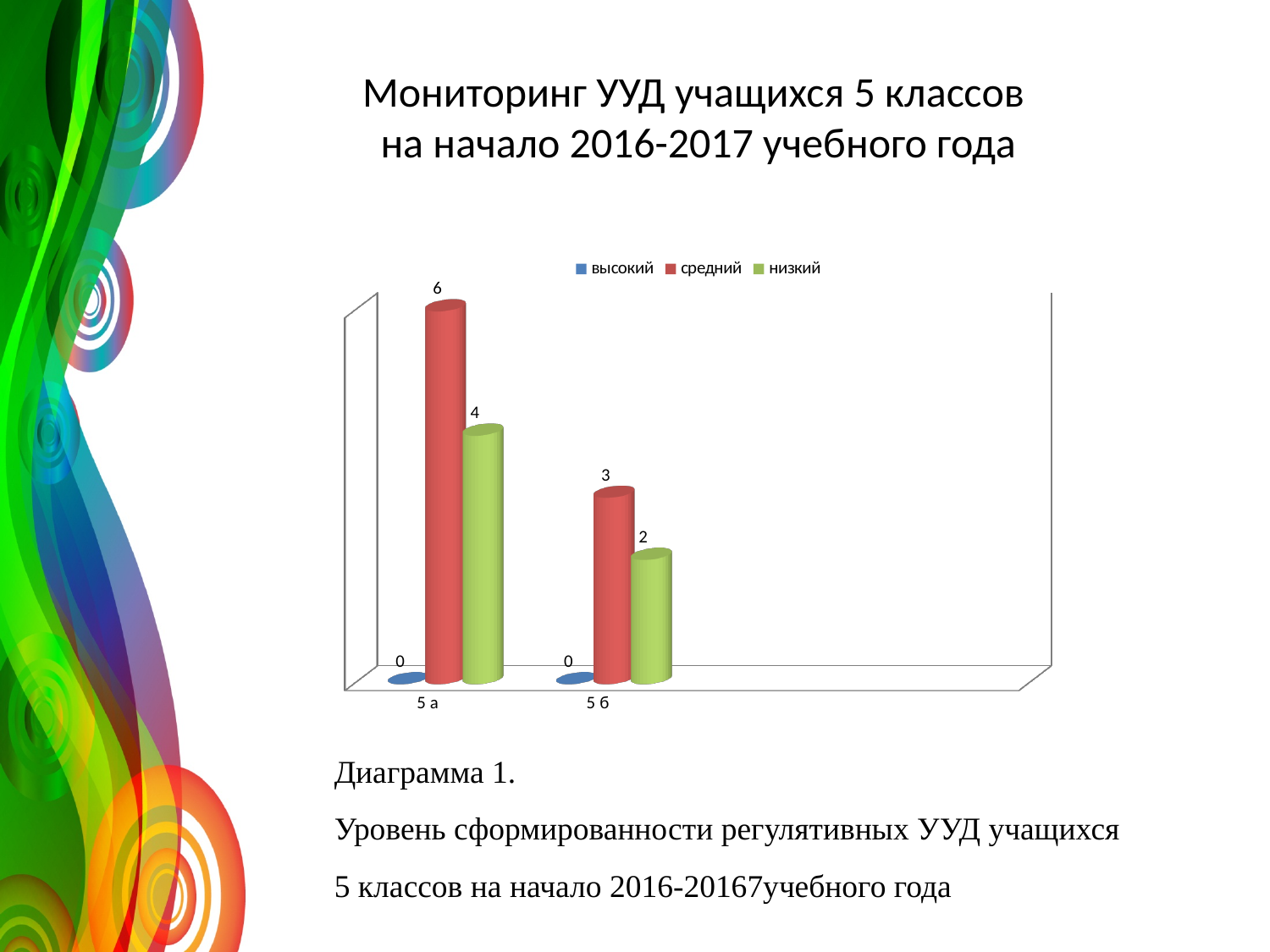
What is the value for the 'средний' series for class '5 а'? 6 What is the difference between the 'средний' values for '5 а' and '5 б'? 3 Which class has the highest value for the 'средний' series? 5 а What is the value for the 'низкий' series for class '5 б'? 2 What is the difference between the 'средний' and 'низкий' values for class '5 а'? 2 Which series has the lowest value for class '5 б'? высокий How many classes (categories) are shown on the x axis? 2 What kind of chart is shown on the slide? bar chart What is the value for the 'высокий' series for class '5 а'? 0 Which is larger: the 'низкий' value for '5 а' or the 'средний' value for '5 б'? низкий for 5 а What is the value for the 'низкий' series for class '5 а'? 4 How many series does the legend list? 3